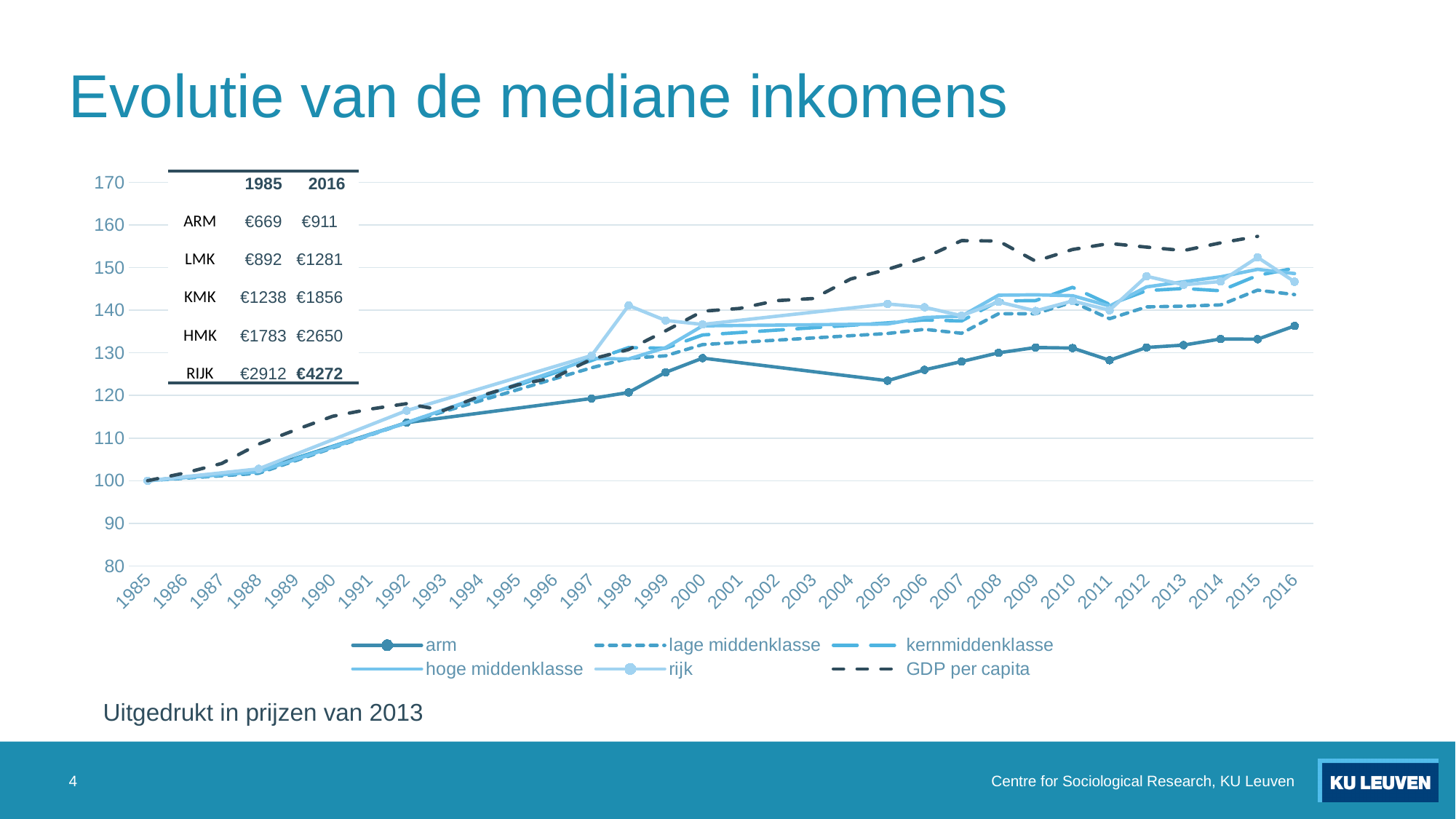
Which series has the lowest value in 2016? arm In 2010, which is larger: the value for arm or the value for GDP per capita? GDP per capita Is the value for arm in 2016 greater or less than 130? greater What is the title of the slide containing the chart? Evolutie van de mediane inkomens How many years are shown along the x axis? 32 What kind of chart is shown on the slide? line chart Is the value for arm in 2005 greater or less than 130? less How many series does the legend list? 6 Does the arm series rise or fall overall from 1985 to 2016? rise What is the value for arm in 1985? 100